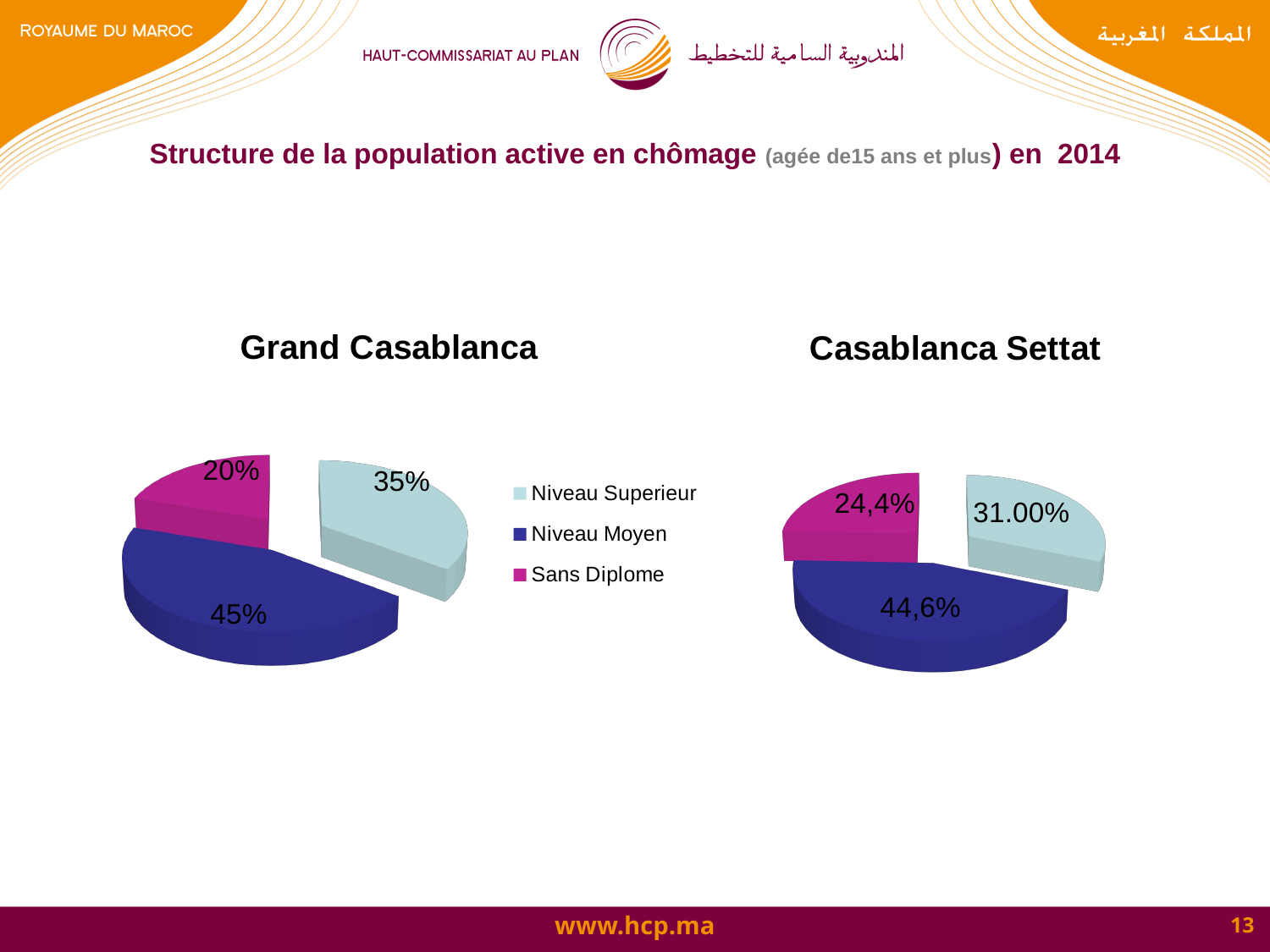
In the Grand Casablanca chart, what share is labelled for Niveau Superieur? 35% In the Casablanca Settat chart, which category has the smallest slice? Sans Diplome In the Casablanca Settat chart, what share is labelled for Niveau Superieur? 31.00% In the Grand Casablanca chart, what share is labelled for Sans Diplome? 20% In the Grand Casablanca chart, which category has the largest slice? Niveau Moyen What kind of chart is the Grand Casablanca chart? Pie chart In the Casablanca Settat chart, what share is labelled for Sans Diplome? 24,4% In the Casablanca Settat chart, what share is labelled for Niveau Moyen? 44,6% In the Casablanca Settat chart, which is larger, Niveau Superieur or Sans Diplome? Niveau Superieur In the Grand Casablanca chart, what is the difference between the Niveau Moyen and Sans Diplome shares? 25% In the Grand Casablanca chart, what share is labelled for Niveau Moyen? 45% How many categories does the legend list? 3